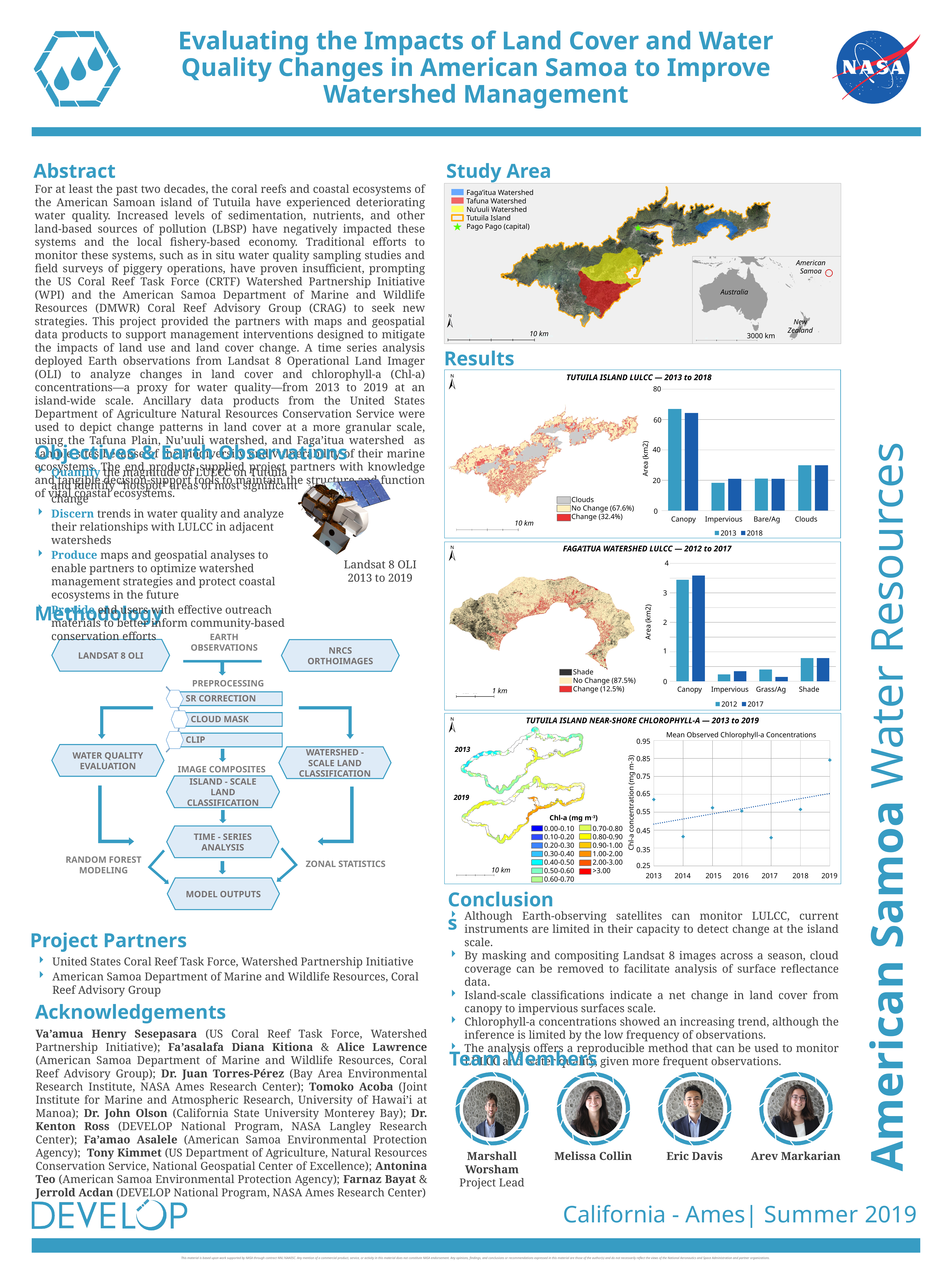
In the Tutuila Island LULCC chart, which category has the smallest area in 2013? Impervious In the Tutuila Island LULCC chart, is the 2013 Impervious area greater or less than 20? less In the Tutuila Island LULCC chart, is the 2013 Canopy area greater or less than 60? greater How many series does the legend of the Tutuila Island LULCC chart list? 2 In the Tutuila Island LULCC chart, which land cover category has the largest area in 2013? Canopy In the Faga'itua Watershed LULCC chart, which category has the largest area? Canopy In the Mean Observed Chlorophyll-a Concentrations chart, which year has the highest concentration? 2019 What type of chart is the Faga'itua Watershed LULCC chart? bar chart In the Faga'itua Watershed LULCC chart, is the 2017 Canopy area greater or less than 3? greater How many land cover categories are shown in the Tutuila Island LULCC chart? 4 In the Faga'itua Watershed LULCC chart, which year has the larger Grass/Ag area, 2012 or 2017? 2012 In the Mean Observed Chlorophyll-a Concentrations chart, does the trend line rise or fall from 2013 to 2019? rise